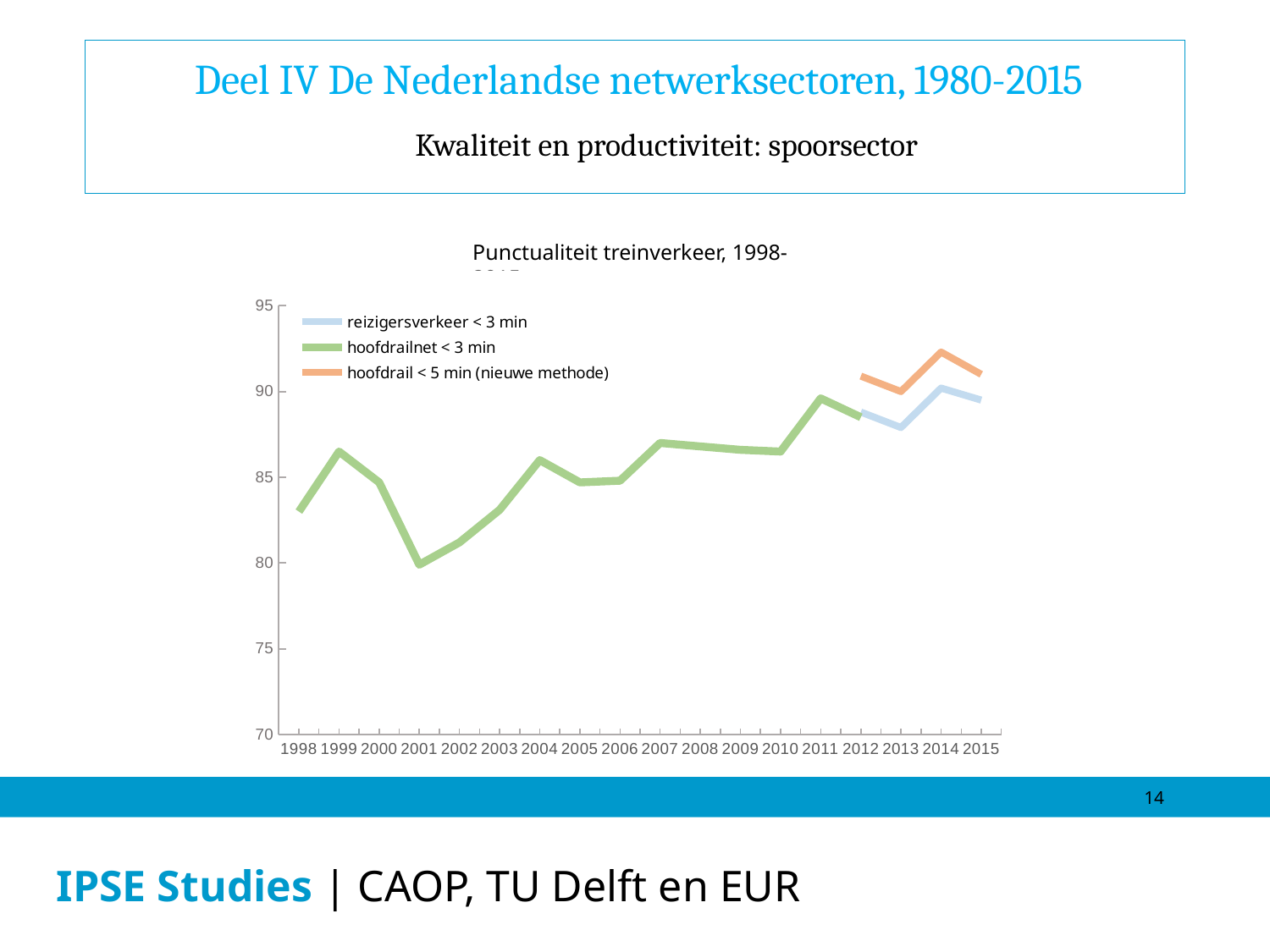
What kind of chart is shown on the slide? line chart Is the value for hoofdrail < 5 min (nieuwe methode) in 2014 greater or less than 90? greater Is the value for hoofdrailnet < 3 min in 2011 greater or less than 85? greater In which year is the hoofdrailnet < 3 min series at its highest? 2011 Does the hoofdrailnet < 3 min series rise or fall from 2001 to 2004? rise Is the value for hoofdrailnet < 3 min in 2001 greater or less than 85? less How many years are shown on the x axis? 18 How many series does the legend list? 3 In 2014, which series has the higher value: hoofdrail < 5 min (nieuwe methode) or reizigersverkeer < 3 min? hoofdrail < 5 min (nieuwe methode) In which year is the hoofdrailnet < 3 min series at its lowest? 2001